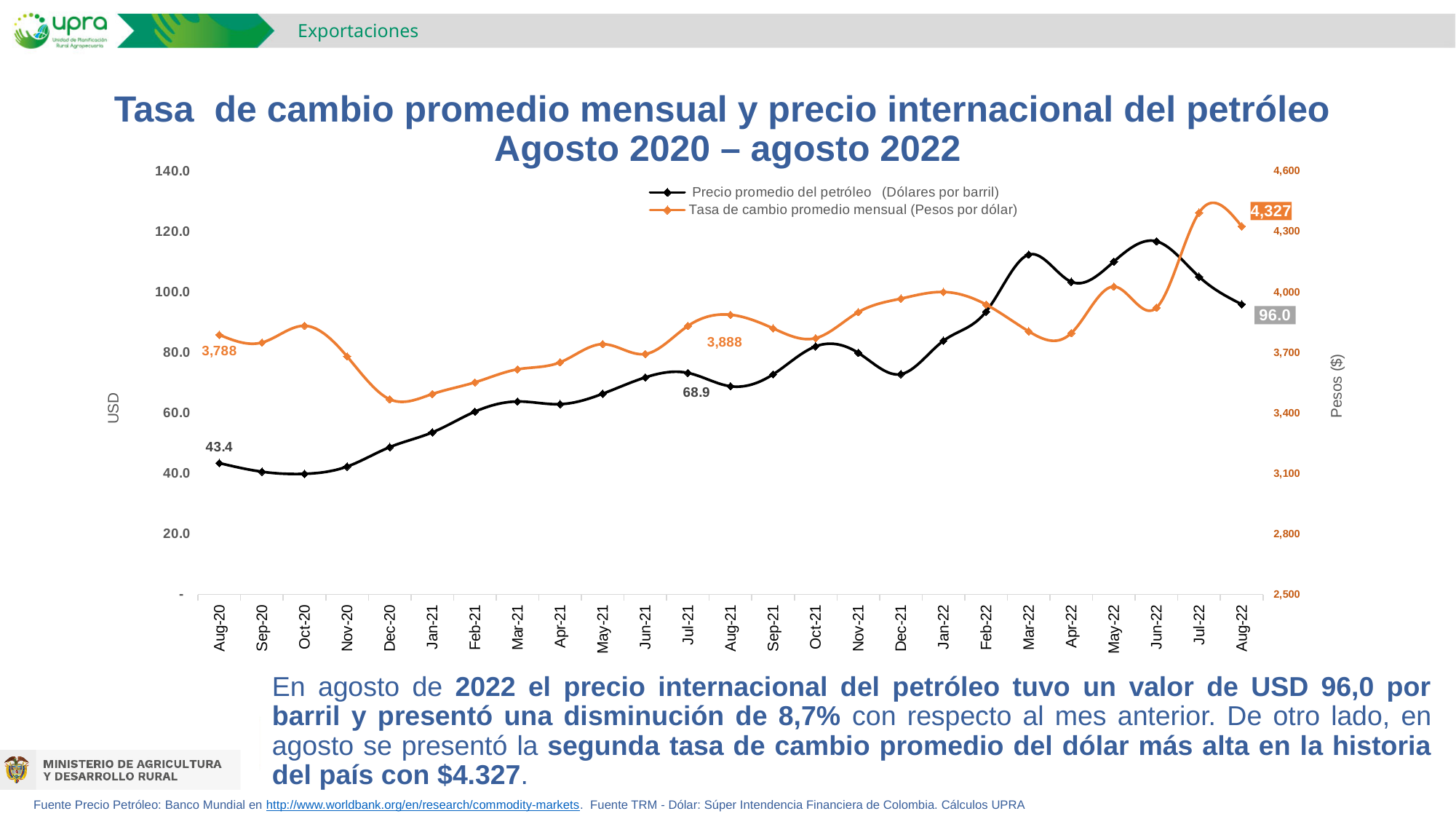
What is the average oil price (Precio promedio del petróleo) shown for Aug-20? 43.4 By how much did the average oil price increase between Aug-20 (43.4) and Aug-22 (96.0)? 52.6 What is the difference between the exchange rate in Aug-22 (4,327) and in Aug-20 (3,788)? 539 What is the average oil price shown for Aug-22? 96.0 In which month does the average oil price reach its highest point? Jun-22 What is the monthly average exchange rate shown for Aug-22? 4,327 What is the monthly average exchange rate (Tasa de cambio promedio mensual) shown for Aug-20? 3,788 In which month does the monthly average exchange rate reach its highest point? Jul-22 How many series does the legend list? 2 Is the average oil price for Mar-22 greater or less than 100.0? greater How many months are plotted along the x axis? 25